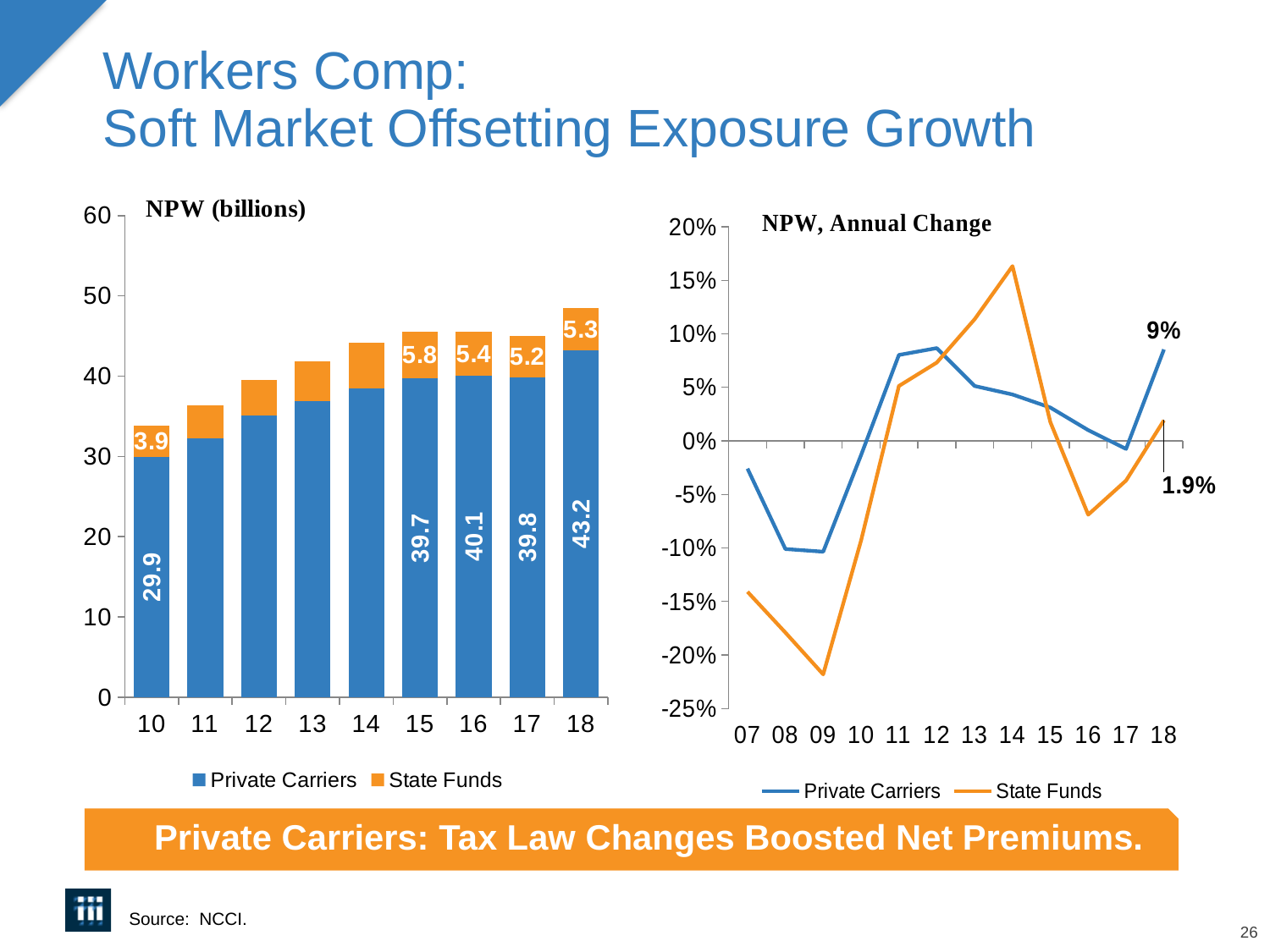
In the "NPW (billions)" chart, what is the Private Carriers value for 18? 43.2 In the "NPW, Annual Change" chart, which series has the larger value in 14, Private Carriers or State Funds? State Funds How many series does the legend of the "NPW, Annual Change" chart list? 2 In the "NPW (billions)" chart, what is the total of the stacked bar for 18? 48.5 In the "NPW (billions)" chart, what is the State Funds value for 15? 5.8 What kind of chart is the right chart titled "NPW, Annual Change"? line chart How many years are shown on the x axis of the "NPW (billions)" chart? 9 In the "NPW (billions)" chart, what is the difference between the Private Carriers values for 18 and 17? 3.4 In the "NPW (billions)" chart, which year has the highest Private Carriers value? 18 What kind of chart is the left chart titled "NPW (billions)"? bar chart In the "NPW, Annual Change" chart, is the State Funds value for 09 greater or less than -20%? less In the "NPW, Annual Change" chart, what is the Private Carriers value for 18? 9%